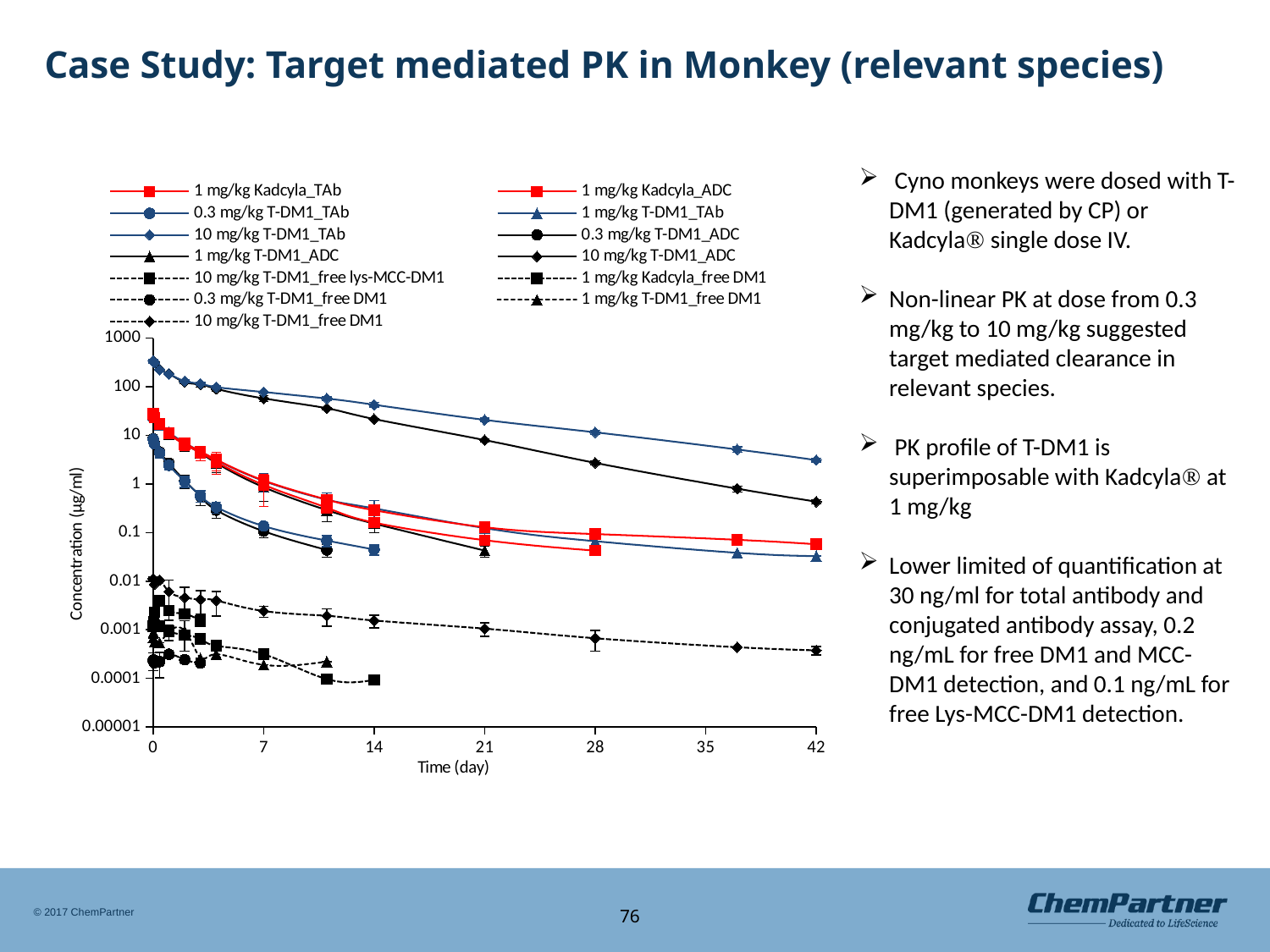
At day 42, which is larger: the value for 10 mg/kg T-DM1_TAb or the value for 10 mg/kg T-DM1_ADC? 10 mg/kg T-DM1_TAb How many series does the chart legend list? 13 Do the concentration values rise or fall as time increases along the x axis? fall Is the value for 10 mg/kg T-DM1_free DM1 at day 42 greater or less than 0.001? less Which series has the highest concentration at day 42? 10 mg/kg T-DM1_TAb What is the label of the chart's x-axis? Time (day) Is the value for 10 mg/kg T-DM1_TAb at day 42 greater or less than 1? greater What is the highest tick value shown on the x axis? 42 What kind of chart is shown on the slide? line chart Is the value for 10 mg/kg T-DM1_ADC at day 42 greater or less than 1? less What is the label of the chart's y-axis? Concentration (µg/ml)